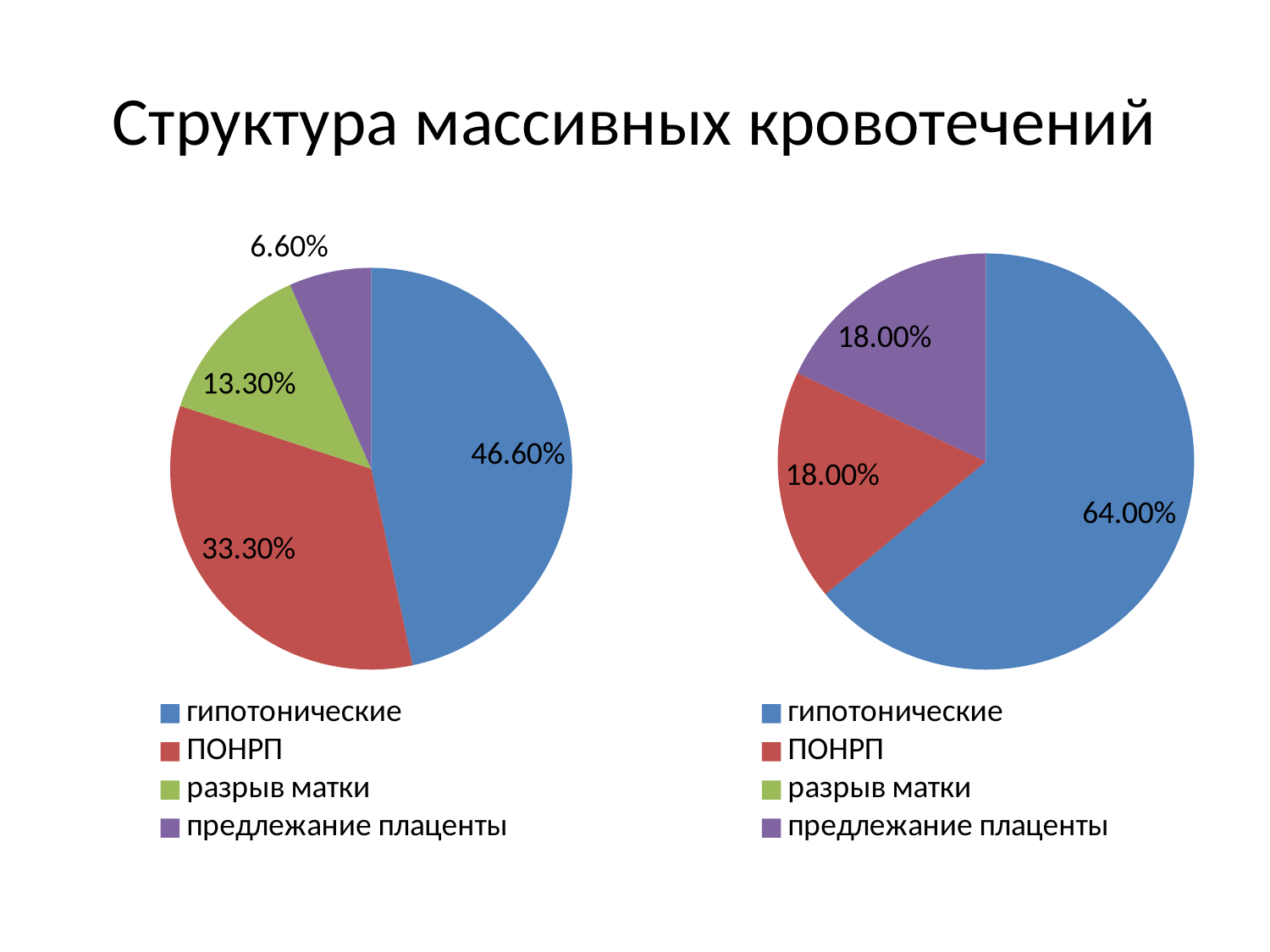
In the left pie chart, what share is shown for разрыв матки? 13.30% What type of chart is the left chart on the slide? pie chart In the left pie chart, which category has the smallest slice? предлежание плаценты How many slices are drawn in the right pie chart? 3 In the right pie chart, which category has the largest slice? гипотонические In the left pie chart, what share is shown for гипотонические? 46.60% In the left pie chart, what share is shown for ПОНРП? 33.30% In the right pie chart, what share is shown for гипотонические? 64.00% In the right pie chart, what share is shown for ПОНРП? 18.00% In the left pie chart, what is the difference between the shares of гипотонические and ПОНРП? 13.30% In the left pie chart, what share is shown for предлежание плаценты? 6.60% How many entries does the legend of the left pie chart list? 4